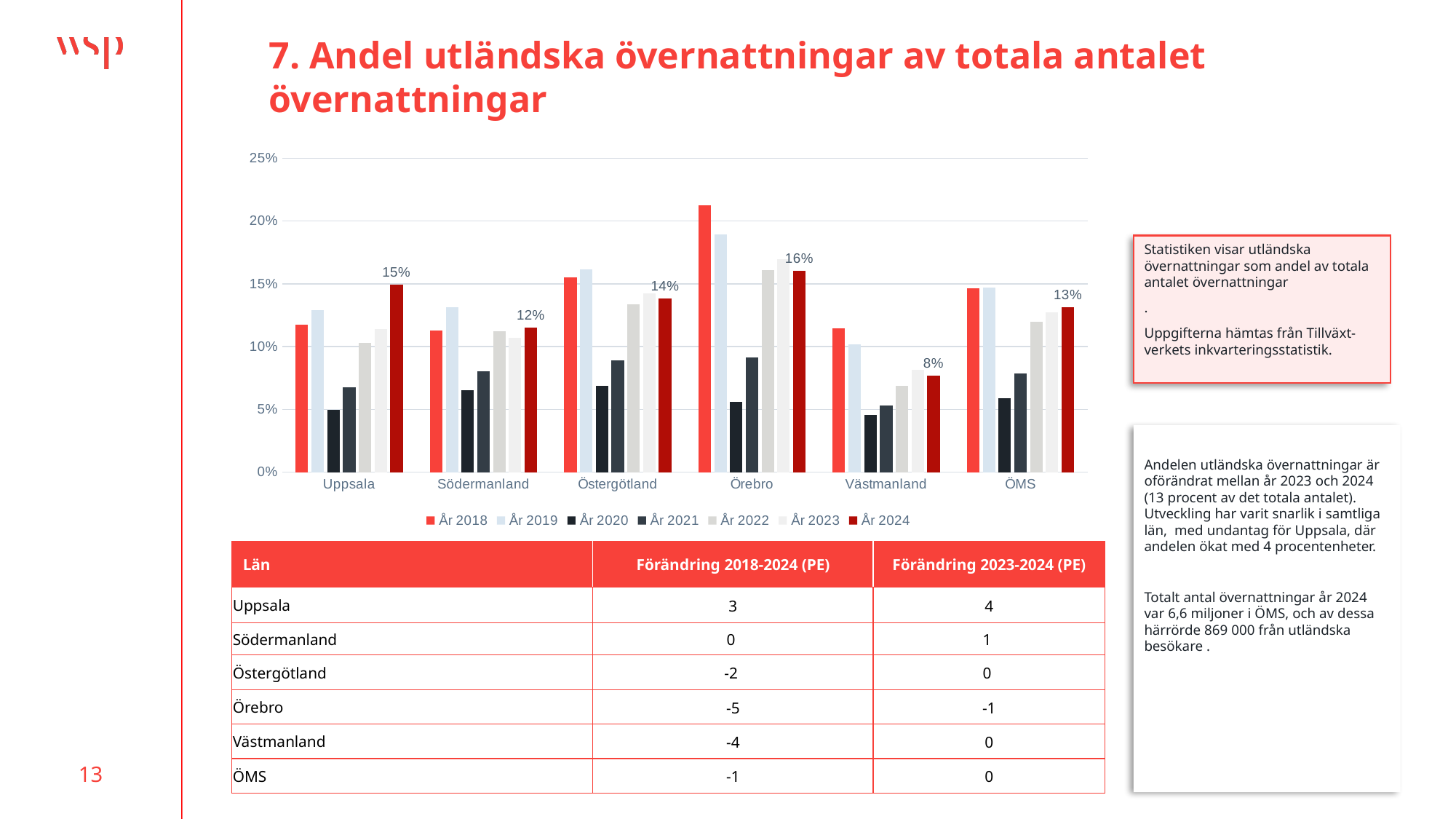
In the År 2024 series, which is larger: Östergötland or Södermanland? Östergötland What is the value for Örebro in the År 2024 series? 16% Which county has the highest value in the År 2024 series? Örebro Which county has the lowest value in the År 2024 series? Västmanland How many series does the chart legend list? 7 Is the value for Örebro in the År 2018 series greater or less than 20%? greater Is the value for Uppsala in the År 2020 series greater or less than 10%? less How many counties (categories) are shown on the x axis of the chart? 6 What is the value for Västmanland in the År 2024 series? 8% What kind of chart is shown on the slide? Bar chart What is the difference between the År 2024 values for Örebro and Västmanland? 8 percentage points What is the value for Uppsala in the År 2024 series? 15%